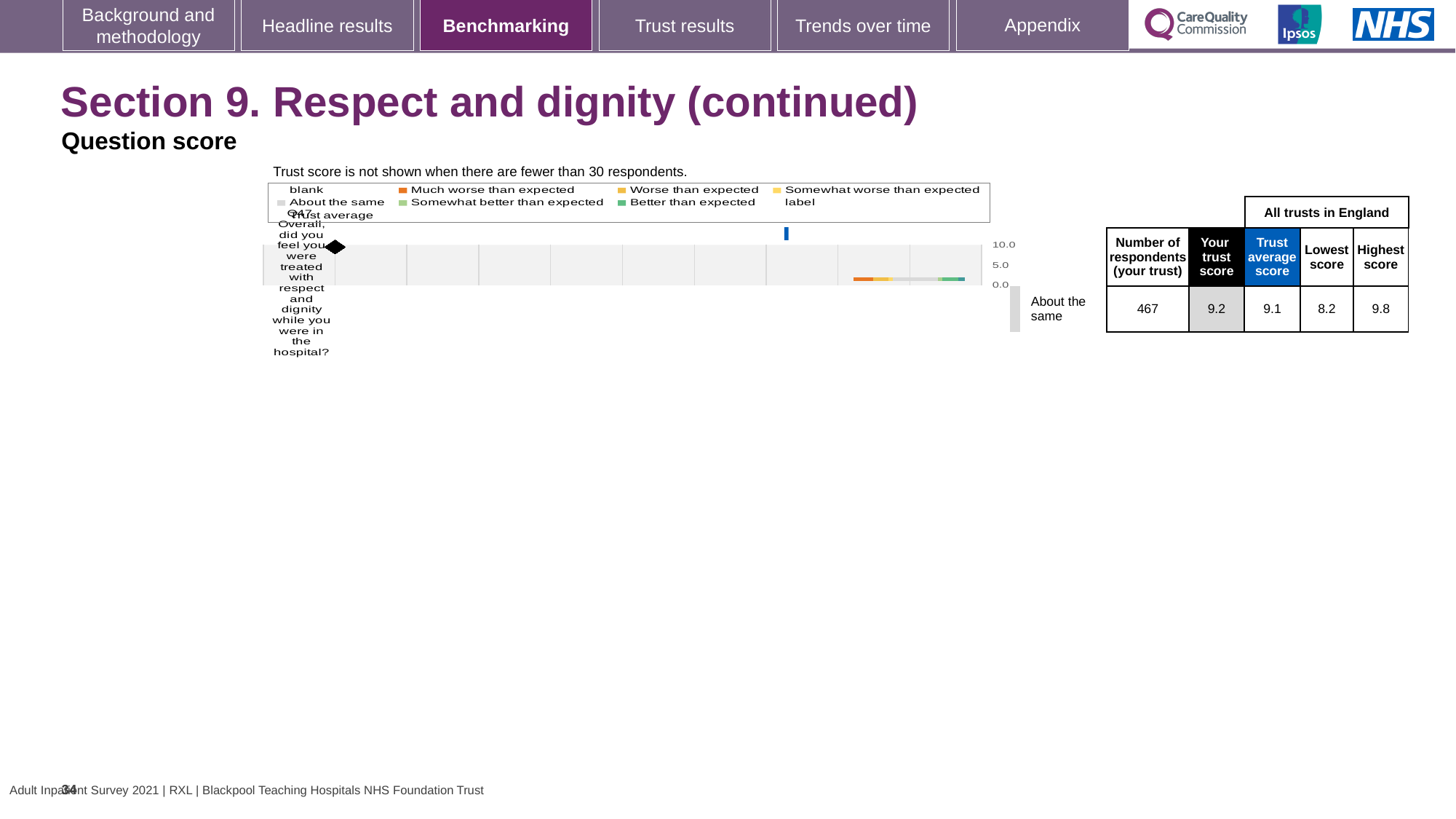
Which benchmarking category is the trust's Q47 result placed in? About the same How many questions are plotted on the chart? 1 What kind of chart is shown on the slide? bar chart What is the trust's score for Q47 (Overall, did you feel you were treated with respect and dignity while you were in the hospital?)? 9.2 What is the highest score among all trusts in England for Q47? 9.8 How many respondents from the trust answered Q47? 467 Which is larger for Q47: your trust score or the trust average score? Your trust score What is the highest value shown on the chart's score axis? 10.0 What is the trust average score for all trusts in England for Q47? 9.1 What is the lowest score among all trusts in England for Q47? 8.2 Is the trust's score for Q47 greater or less than 5.0? greater What is the difference between the highest score and the lowest score for Q47? 1.6